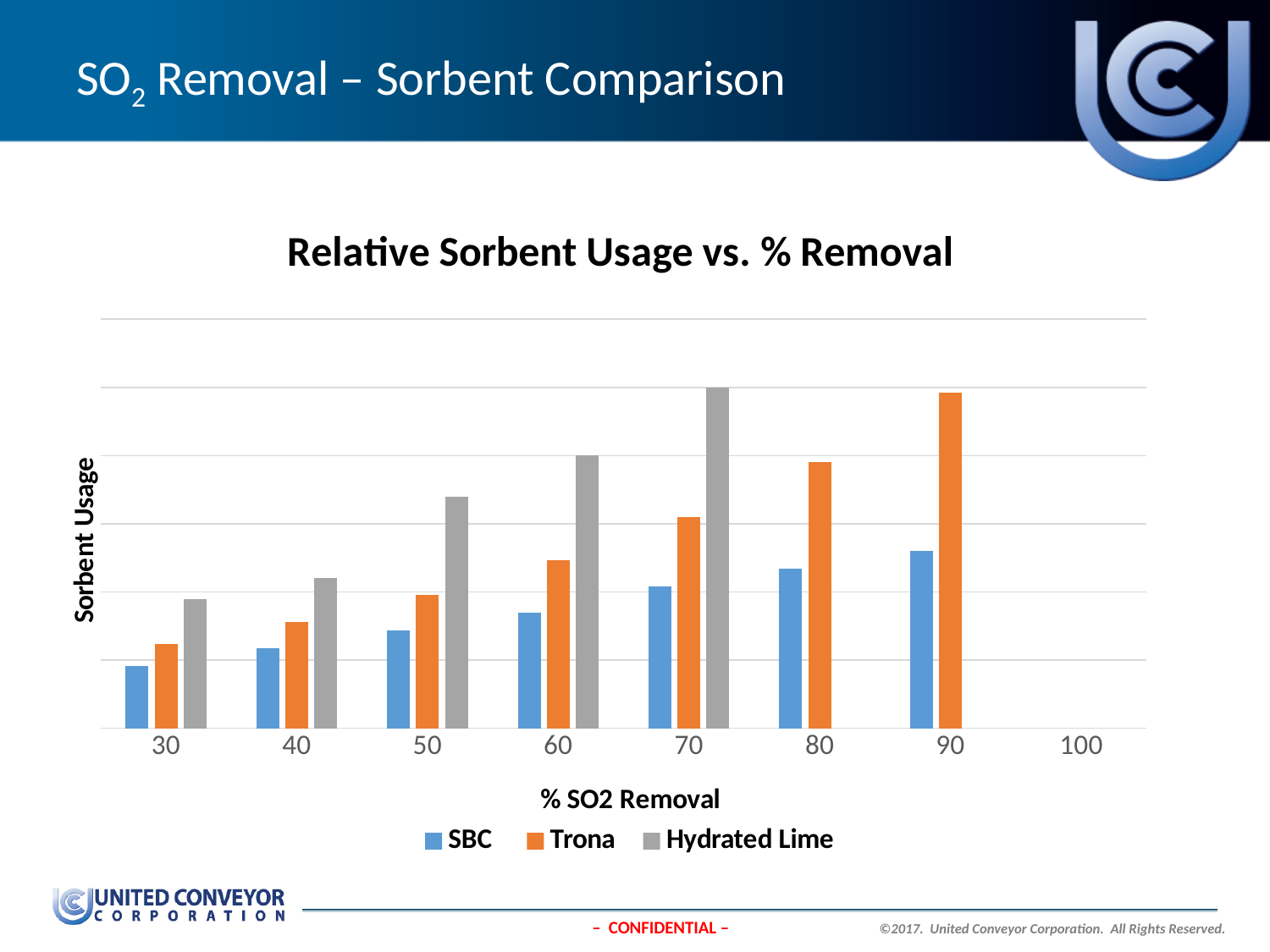
At which % SO2 Removal value is the Hydrated Lime bar highest? 70 How many categories are labelled on the x axis? 8 At which % SO2 Removal value is the Trona bar highest? 90 What is the title of the chart? Relative Sorbent Usage vs. % Removal Do the SBC values rise or fall as % SO2 Removal increases from 30 to 90? Rise What is the label of the x axis? % SO2 Removal Which series has the lowest bar at every % SO2 Removal value where it is plotted? SBC At 60% SO2 Removal, which is larger: Hydrated Lime or Trona? Hydrated Lime What kind of chart is shown on the slide? Bar chart At which % SO2 Removal value is the SBC bar lowest? 30 How many series does the legend list? 3 At 90% SO2 Removal, which is larger: Trona or SBC? Trona